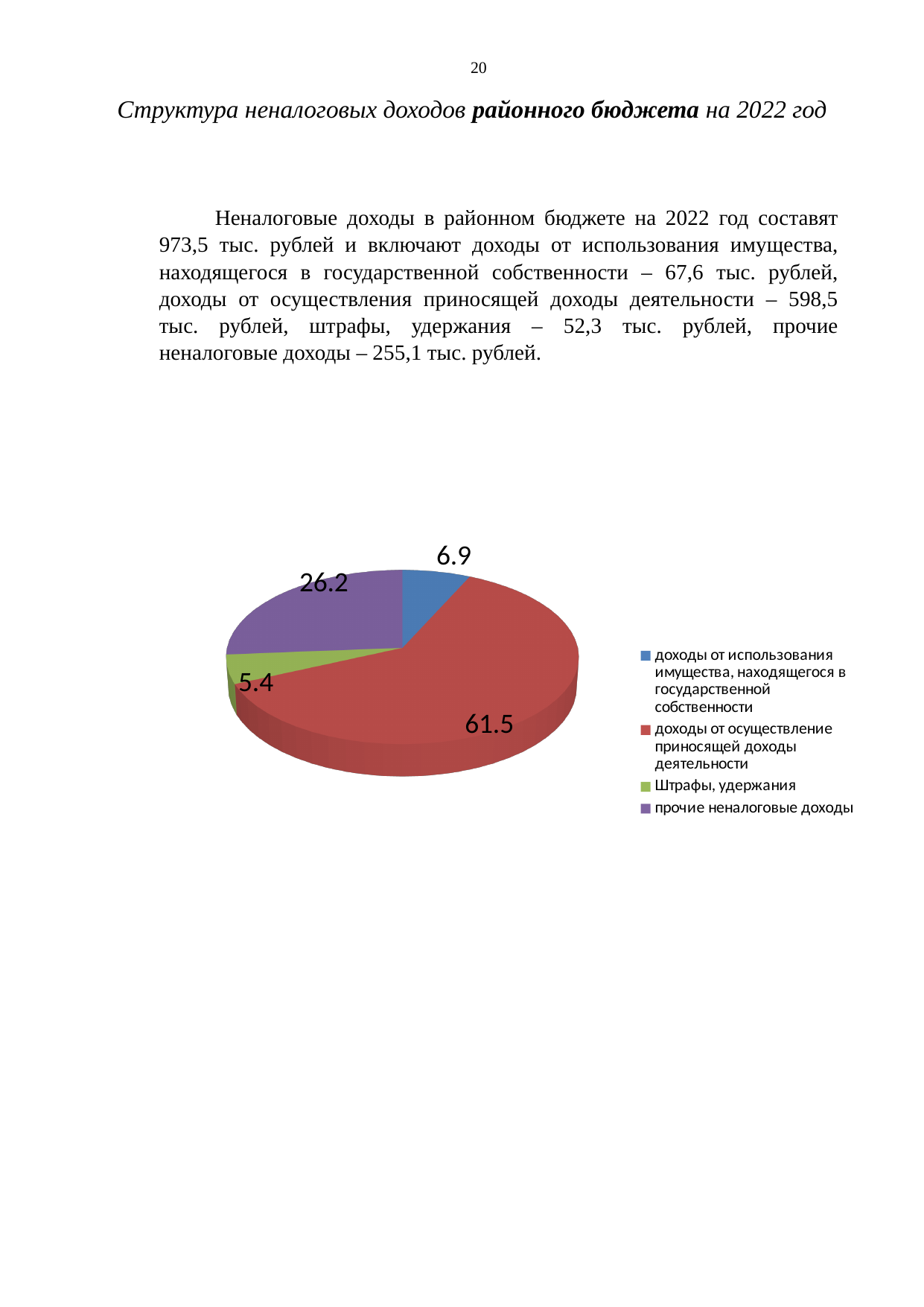
Which category has the largest slice of the pie? доходы от осуществление приносящей доходы деятельности What type of chart is shown on the slide? pie chart What is the value shown for the slice 'доходы от использования имущества, находящегося в государственной собственности'? 6.9 What is the difference between the values for 'доходы от осуществление приносящей доходы деятельности' and 'прочие неналоговые доходы'? 35.3 What is the value shown for the slice 'прочие неналоговые доходы'? 26.2 What is the value shown for the slice 'Штрафы, удержания'? 5.4 How many entries does the legend list? 4 Which is larger: the slice for 'прочие неналоговые доходы' or the slice for 'доходы от использования имущества, находящегося в государственной собственности'? прочие неналоговые доходы What is the value shown for the slice 'доходы от осуществление приносящей доходы деятельности'? 61.5 How many slices does the pie chart have? 4 What colour is the slice for 'Штрафы, удержания'? green Which category has the smallest slice of the pie? Штрафы, удержания